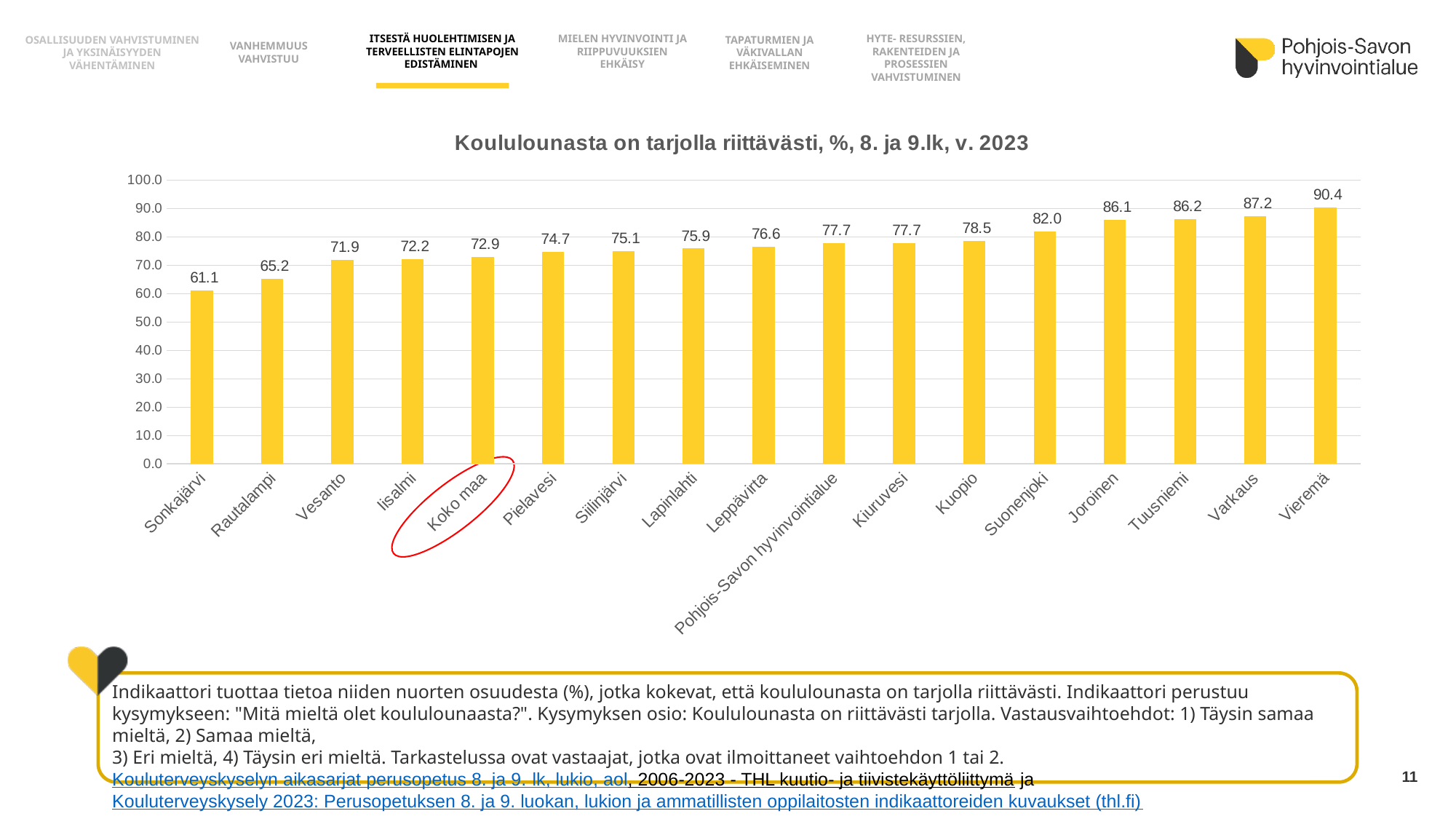
What is the value for Sonkajärvi? 61.1 What is the value for Kuopio? 78.5 Which category has the highest value? Vieremä Which category has the lowest value? Sonkajärvi What is the difference between the values for Vieremä and Sonkajärvi? 29.3 What is the title of the chart? Koululounasta on tarjolla riittävästi, %, 8. ja 9.lk, v. 2023 What is the value for Pohjois-Savon hyvinvointialue? 77.7 Is the value for Rautalampi greater or less than 70.0? less Which has a larger value, Suonenjoki or Lapinlahti? Suonenjoki What is the value for Koko maa? 72.9 How many categories are shown on the x axis? 17 What kind of chart is shown on the slide? bar chart